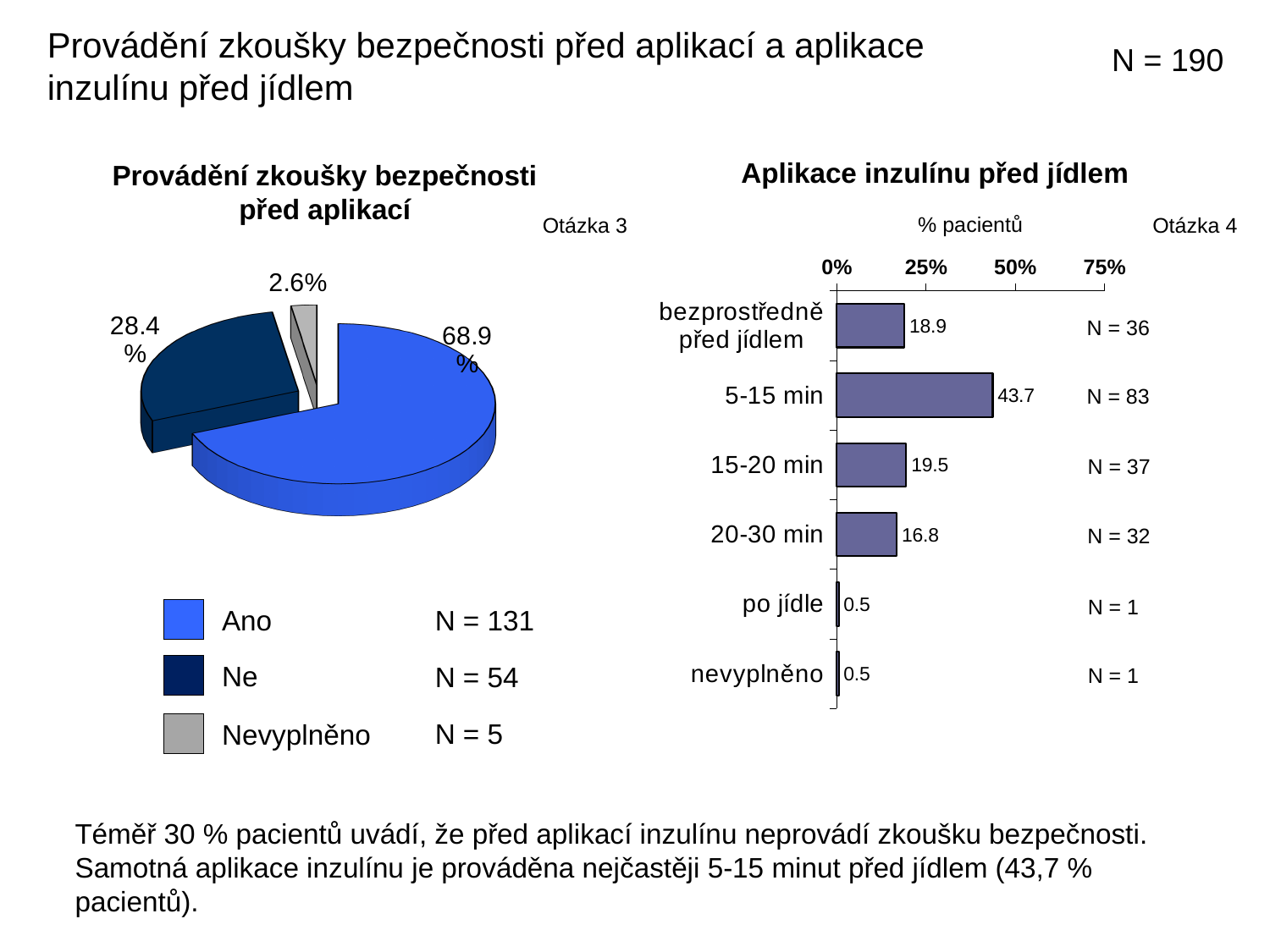
In the chart 'Aplikace inzulínu před jídlem', what is the difference between the values for '5-15 min' and '15-20 min'? 24.2 In the chart 'Provádění zkoušky bezpečnosti před aplikací', how many categories does the legend list? 3 In the chart 'Aplikace inzulínu před jídlem', how many categories are plotted? 6 In the chart 'Aplikace inzulínu před jídlem', what kind of chart is used? Bar chart In the chart 'Provádění zkoušky bezpečnosti před aplikací', which category has the smallest slice? Nevyplněno In the chart 'Aplikace inzulínu před jídlem', what is the value for '5-15 min'? 43.7 In the chart 'Provádění zkoušky bezpečnosti před aplikací', what percentage is shown for 'Ne'? 28.4% In the chart 'Aplikace inzulínu před jídlem', what is the value for '20-30 min'? 16.8 In the chart 'Provádění zkoušky bezpečnosti před aplikací', what percentage is shown for 'Ano'? 68.9% In the chart 'Aplikace inzulínu před jídlem', which is larger: the value for 'bezprostředně před jídlem' or for '15-20 min'? 15-20 min In the chart 'Provádění zkoušky bezpečnosti před aplikací', what kind of chart is used? Pie chart In the chart 'Aplikace inzulínu před jídlem', which category has the highest value? 5-15 min